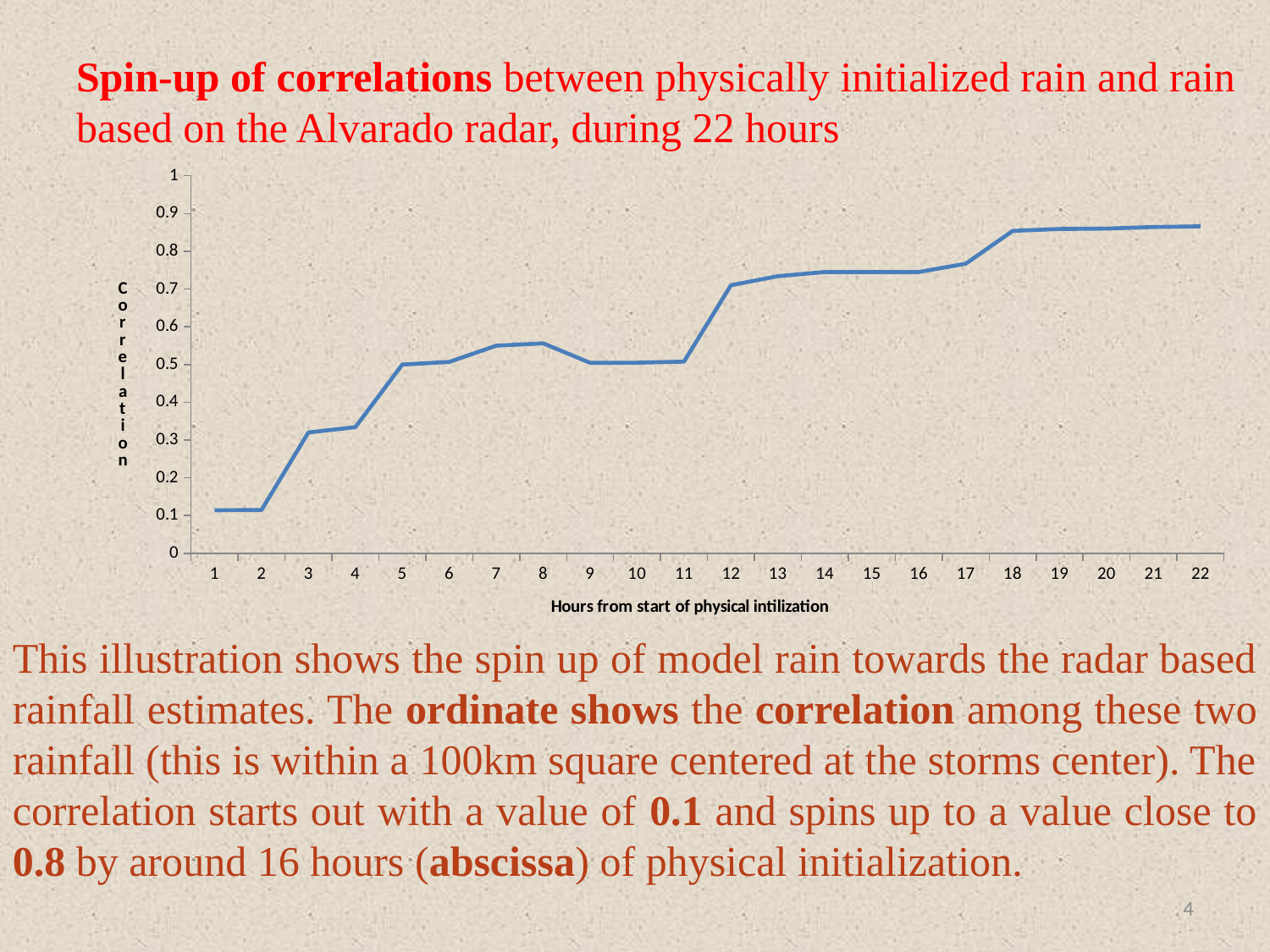
How many hourly data points are plotted on the chart? 22 Which has the higher correlation value, hour 3 or hour 9? hour 9 Is the correlation value at hour 1 greater or less than 0.2? less What kind of chart is shown on the slide? line chart Does the correlation generally rise or fall as the hours from the start of physical initialization increase? rise Is the correlation value at hour 9 greater or less than 0.6? less Is the correlation value at hour 18 greater or less than 0.8? greater What is the label of the horizontal axis of the chart? Hours from start of physical initilization Which has the higher correlation value, hour 8 or hour 12? hour 12